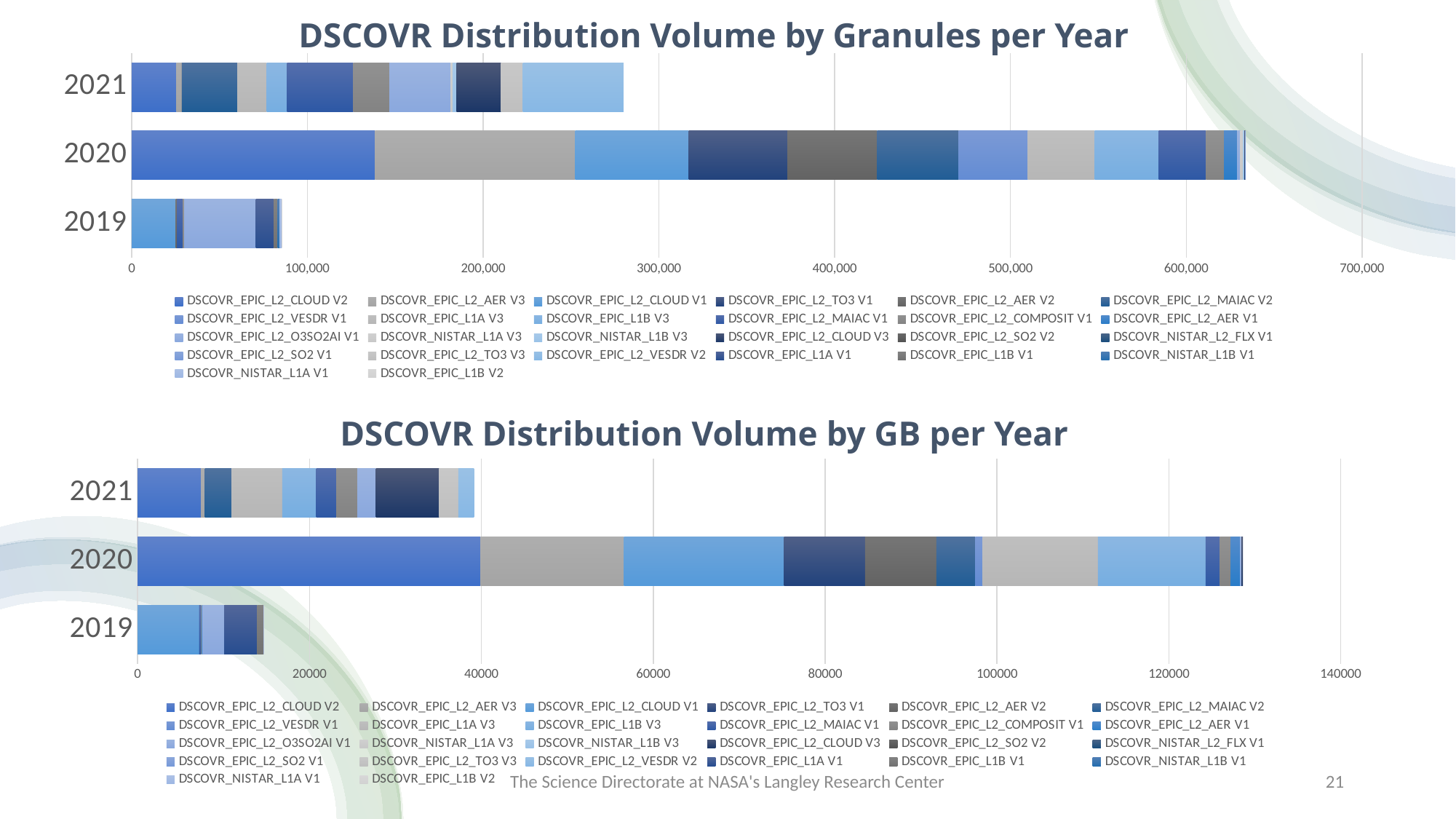
In the 'DSCOVR Distribution Volume by Granules per Year' chart, is the total for 2021 greater or less than 300,000? less In the 'DSCOVR Distribution Volume by GB per Year' chart, is the total for 2020 greater or less than 120000? greater In the 'DSCOVR Distribution Volume by Granules per Year' chart, which year has the longest total bar? 2020 In the 'DSCOVR Distribution Volume by GB per Year' chart, is the total for 2019 greater or less than 20000? less In the 'DSCOVR Distribution Volume by GB per Year' chart, which year has the largest total? 2020 In the 'DSCOVR Distribution Volume by Granules per Year' chart, which year has the shortest total bar? 2019 In the 'DSCOVR Distribution Volume by GB per Year' chart, which year has the smallest total? 2019 In the 'DSCOVR Distribution Volume by Granules per Year' chart, how many years are shown on the vertical axis? 3 How many series does the legend of the 'DSCOVR Distribution Volume by GB per Year' chart list? 26 What kind of chart is the 'DSCOVR Distribution Volume by Granules per Year' chart? Stacked bar chart In the 'DSCOVR Distribution Volume by GB per Year' chart, which year has the larger total, 2021 or 2019? 2021